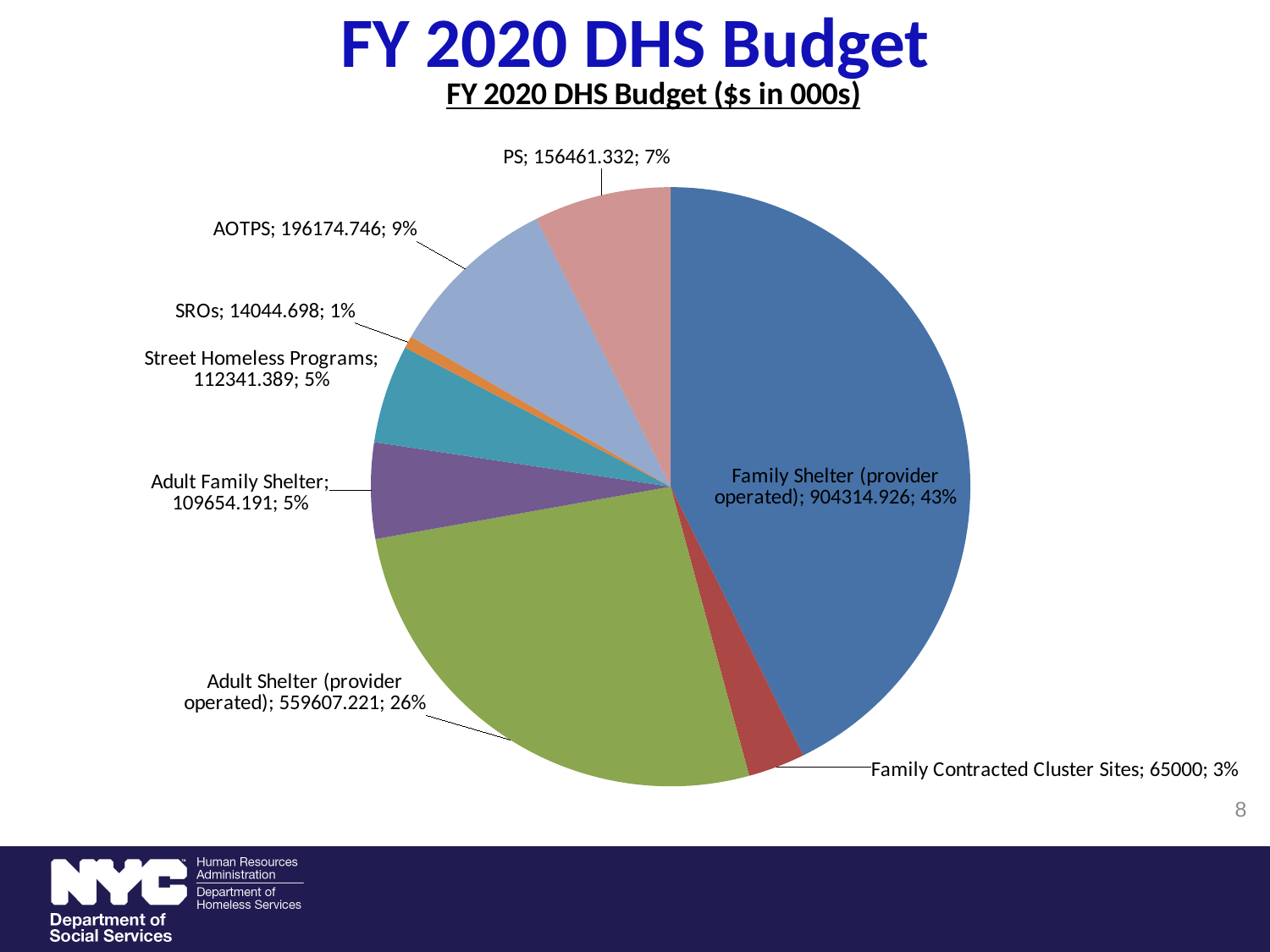
Which is larger, the value for AOTPS or the value for PS? AOTPS What is the value for Family Shelter (provider operated)? 904314.926 Which category has the largest slice of the pie? Family Shelter (provider operated) What is the title of the chart? FY 2020 DHS Budget ($s in 000s) What share of the pie does AOTPS represent? 9% What type of chart is shown on the slide? Pie chart What is the value for Adult Shelter (provider operated)? 559607.221 How many slices does the pie chart have? 8 What is the value for Family Contracted Cluster Sites? 65000 What share of the pie does Street Homeless Programs represent? 5% What is the difference between the values for Family Shelter (provider operated) and Adult Shelter (provider operated)? 344707.705 Which category has the smallest slice of the pie? SROs